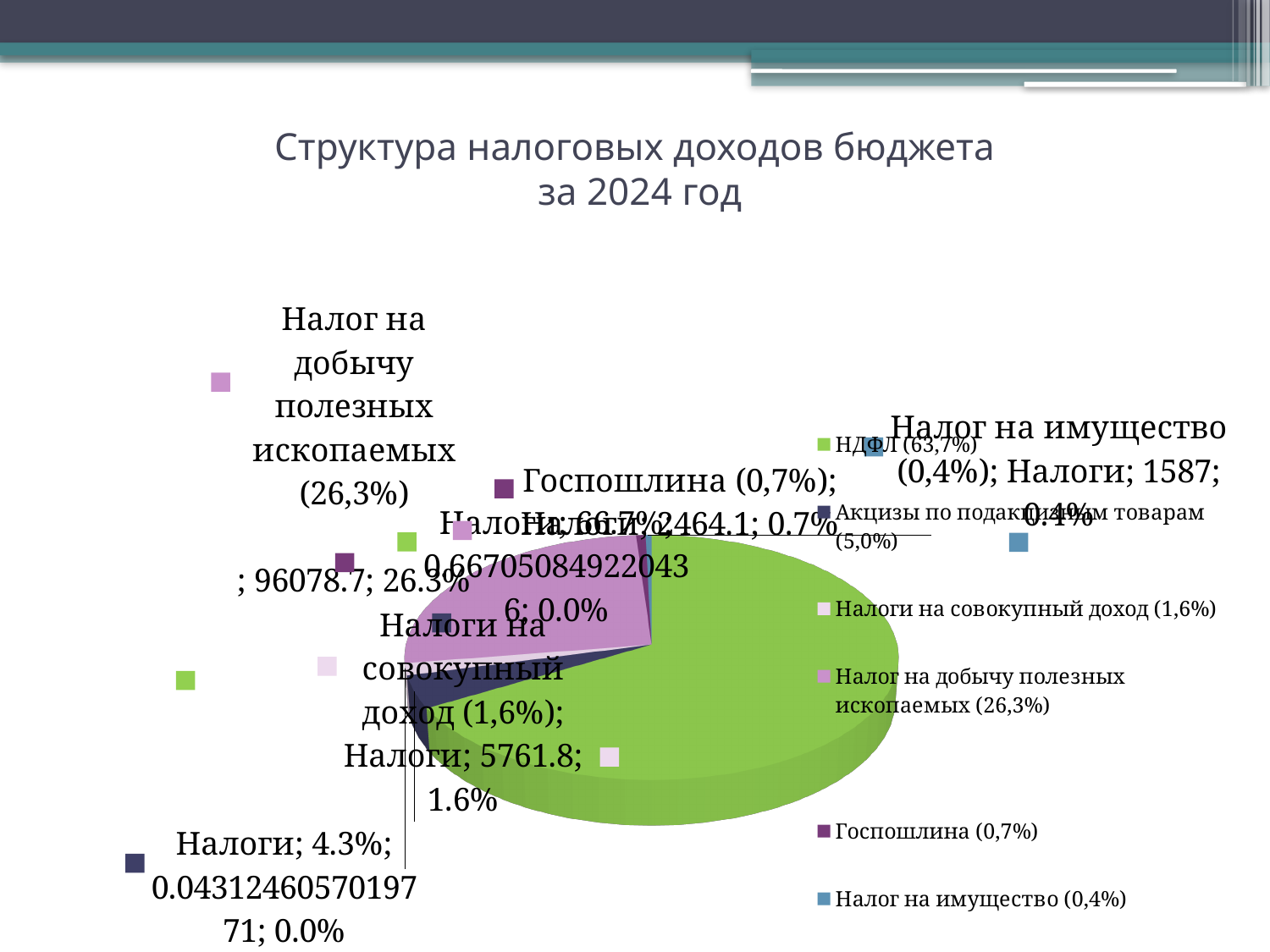
Which category has the smallest share of the pie? Налог на имущество (0,4%) What kind of chart is shown on the slide? pie chart What share of the pie does Налог на добычу полезных ископаемых have? 26,3% What share of the pie does Акцизы по подакцизным товарам have? 4.3% What value is shown in the data label for Налог на добычу полезных ископаемых? 96078.7 How many categories does the legend of the pie chart list? 6 What is the title of the chart on the slide? Структура налоговых доходов бюджета за 2024 год What value is shown in the data label for Налоги на совокупный доход? 5761.8 Which category has the largest share of the pie? НДФЛ (63,7%) What value is shown in the data label for Налог на имущество? 1587 Which has a larger share of the pie, НДФЛ or Налог на добычу полезных ископаемых? НДФЛ What share of the pie does НДФЛ have? 66.7%